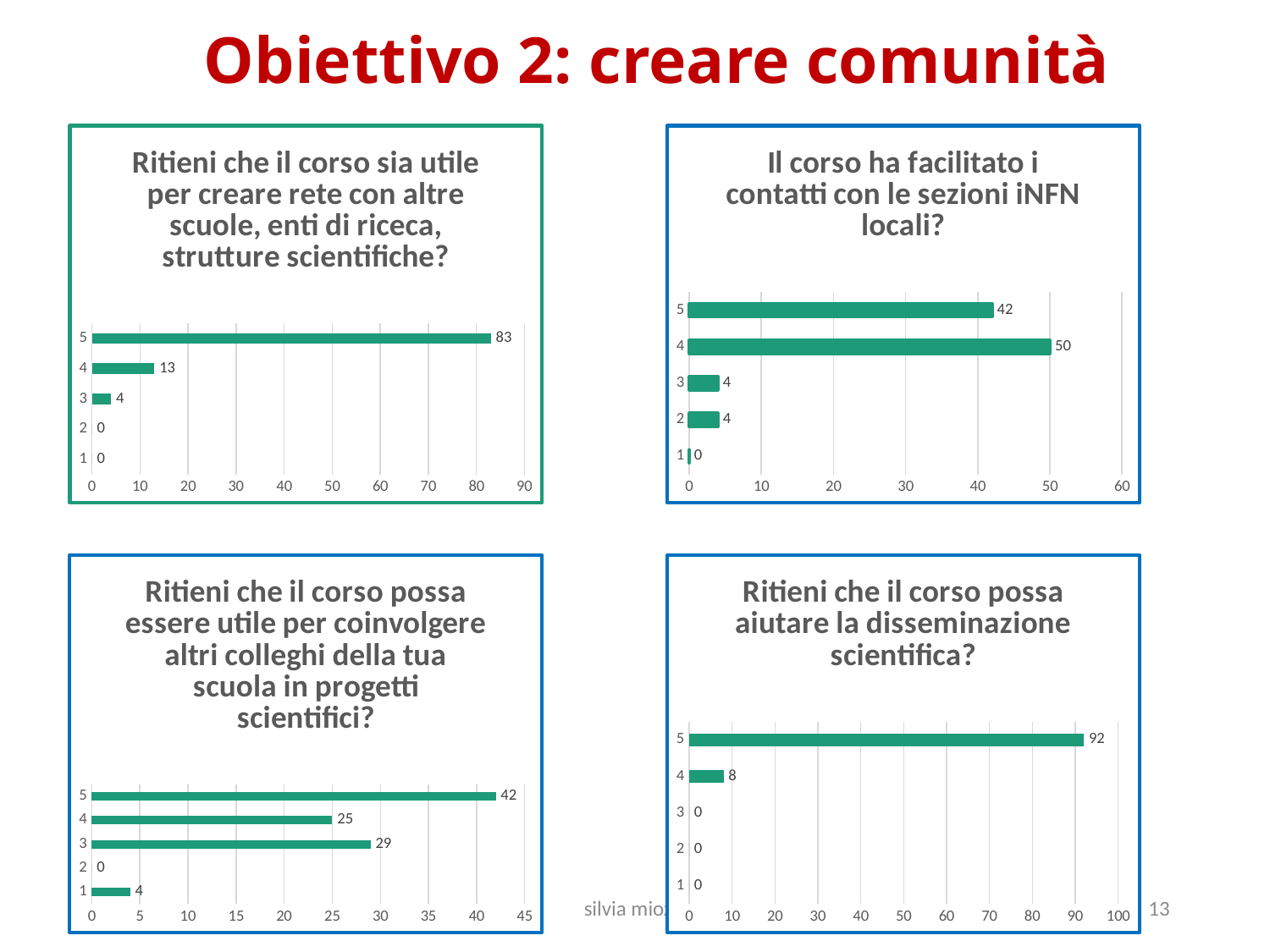
In the top-right chart ("Il corso ha facilitato i contatti con le sezioni iNFN locali?"), what is the value for category 5? 42 In the bottom-left chart ("Ritieni che il corso possa essere utile per coinvolgere altri colleghi..."), which is larger, the value for category 4 or category 3? 3 In the top-right chart ("Il corso ha facilitato i contatti con le sezioni iNFN locali?"), which category has the highest value? 4 In the top-right chart ("Il corso ha facilitato i contatti con le sezioni iNFN locali?"), is the value for category 4 greater or less than 40? greater In the bottom-left chart ("Ritieni che il corso possa essere utile per coinvolgere altri colleghi..."), what is the value for category 1? 4 How many categories does the bottom-right chart ("Ritieni che il corso possa aiutare la disseminazione scientifica?") show? 5 In the bottom-right chart ("Ritieni che il corso possa aiutare la disseminazione scientifica?"), what is the value for category 5? 92 In the bottom-right chart ("Ritieni che il corso possa aiutare la disseminazione scientifica?"), what is the difference between the values for category 5 and category 4? 84 In the top-left chart ("Ritieni che il corso sia utile per creare rete..."), what is the value for category 5? 83 In the bottom-left chart ("Ritieni che il corso possa essere utile per coinvolgere altri colleghi..."), what is the value for category 3? 29 In the top-left chart ("Ritieni che il corso sia utile per creare rete..."), what is the difference between the values for category 5 and category 4? 70 What kind of chart is the top-left chart ("Ritieni che il corso sia utile per creare rete...")? Bar chart